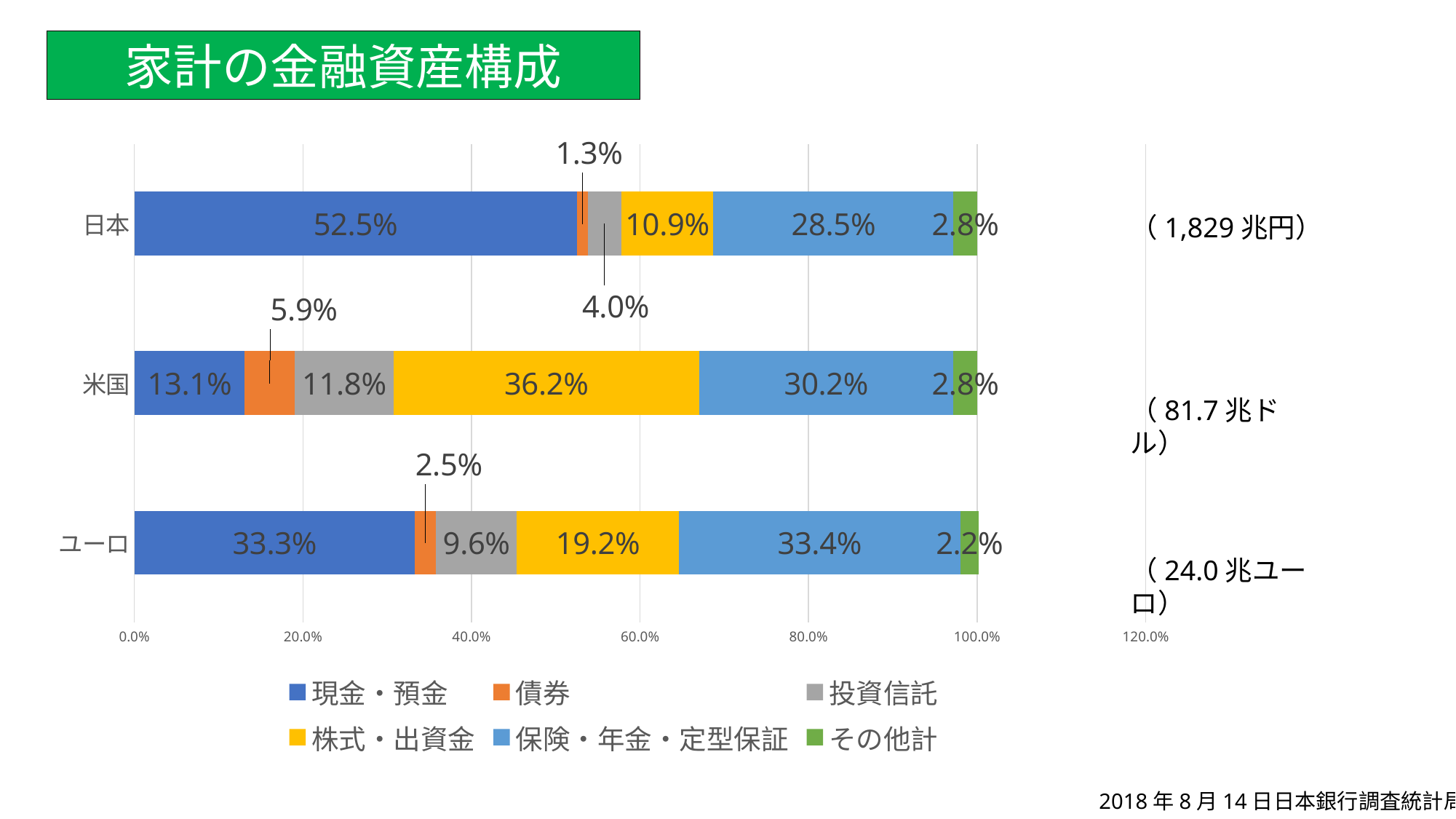
Which category has the highest value for 現金・預金? 日本 What kind of chart is shown on the slide? stacked bar chart What is the value of 株式・出資金 for 米国? 36.2% What is the value of 債券 for 日本? 1.3% What is the value of 保険・年金・定型保証 for ユーロ? 33.4% What is the value of 現金・預金 for 日本? 52.5% How many series does the legend list? 6 How many categories are shown on the y axis? 3 What is the value of 投資信託 for 米国? 11.8% Which category has the lowest value for 株式・出資金? 日本 Which is larger, the 債券 value for 米国 or for ユーロ? 米国 What is the difference between the 現金・預金 values for 日本 and 米国? 39.4%